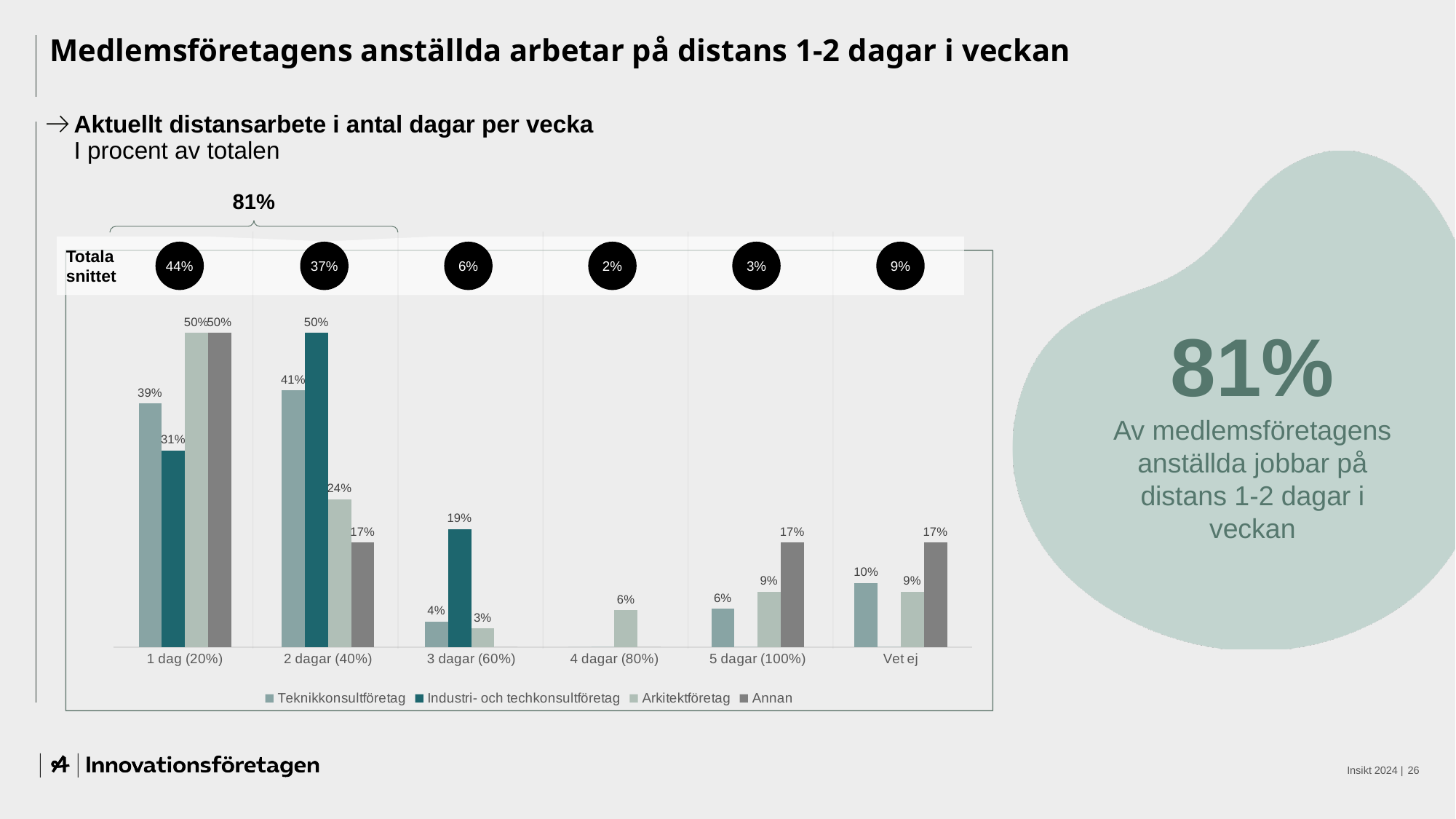
How many categories are shown on the x axis? 6 What is the 'Totala snittet' value for 3 dagar (60%)? 6% What is the value for Teknikkonsultföretag at 1 dag (20%)? 39% Which category has the lowest 'Totala snittet' value? 4 dagar (80%) What kind of chart is shown on the slide? bar chart Which category has the highest 'Totala snittet' value? 1 dag (20%) Which is larger at 2 dagar (40%): Arkitektföretag or Annan? Arkitektföretag How many series does the legend list? 4 What percentage is shown in the large callout on the right of the slide? 81% What is the difference between Industri- och techkonsultföretag and Teknikkonsultföretag at 3 dagar (60%)? 15% What is the value for Industri- och techkonsultföretag at 2 dagar (40%)? 50% What is the value for Arkitektföretag at 4 dagar (80%)? 6%